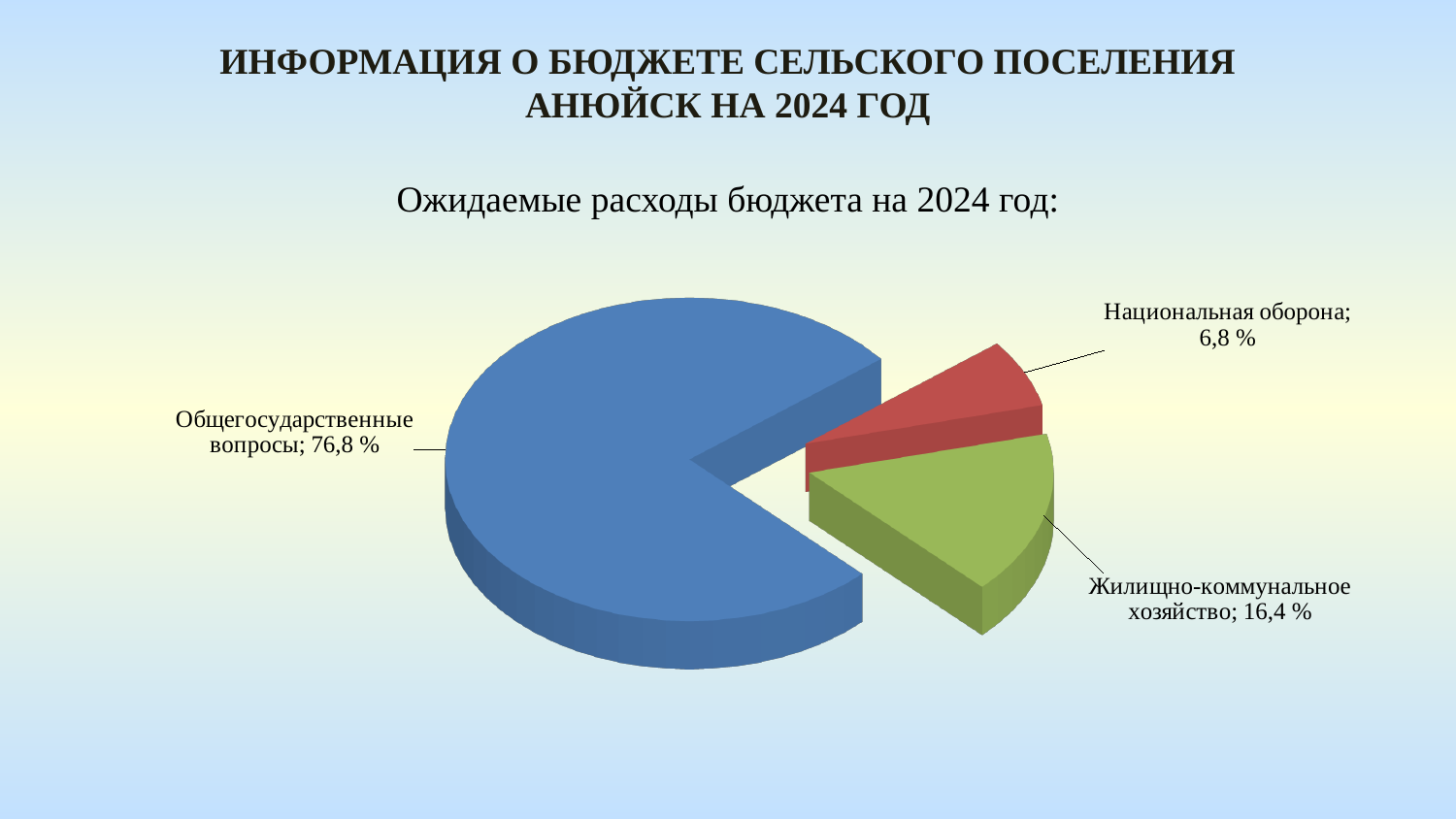
What is the subtitle above the chart? Ожидаемые расходы бюджета на 2024 год: What is the difference in percentage points between Общегосударственные вопросы and Жилищно-коммунальное хозяйство? 60,4 What kind of chart is shown on the slide? Pie chart What share of the pie does Общегосударственные вопросы have? 76,8 % Which is larger: the share for Жилищно-коммунальное хозяйство or for Национальная оборона? Жилищно-коммунальное хозяйство Which category has the largest share of the pie? Общегосударственные вопросы What colour is the slice for Национальная оборона? Red How many categories are shown in the pie chart? 3 What share of the pie does Национальная оборона have? 6,8 % Which category has the smallest share of the pie? Национальная оборона What is the difference in percentage points between Жилищно-коммунальное хозяйство and Национальная оборона? 9,6 What share of the pie does Жилищно-коммунальное хозяйство have? 16,4 %